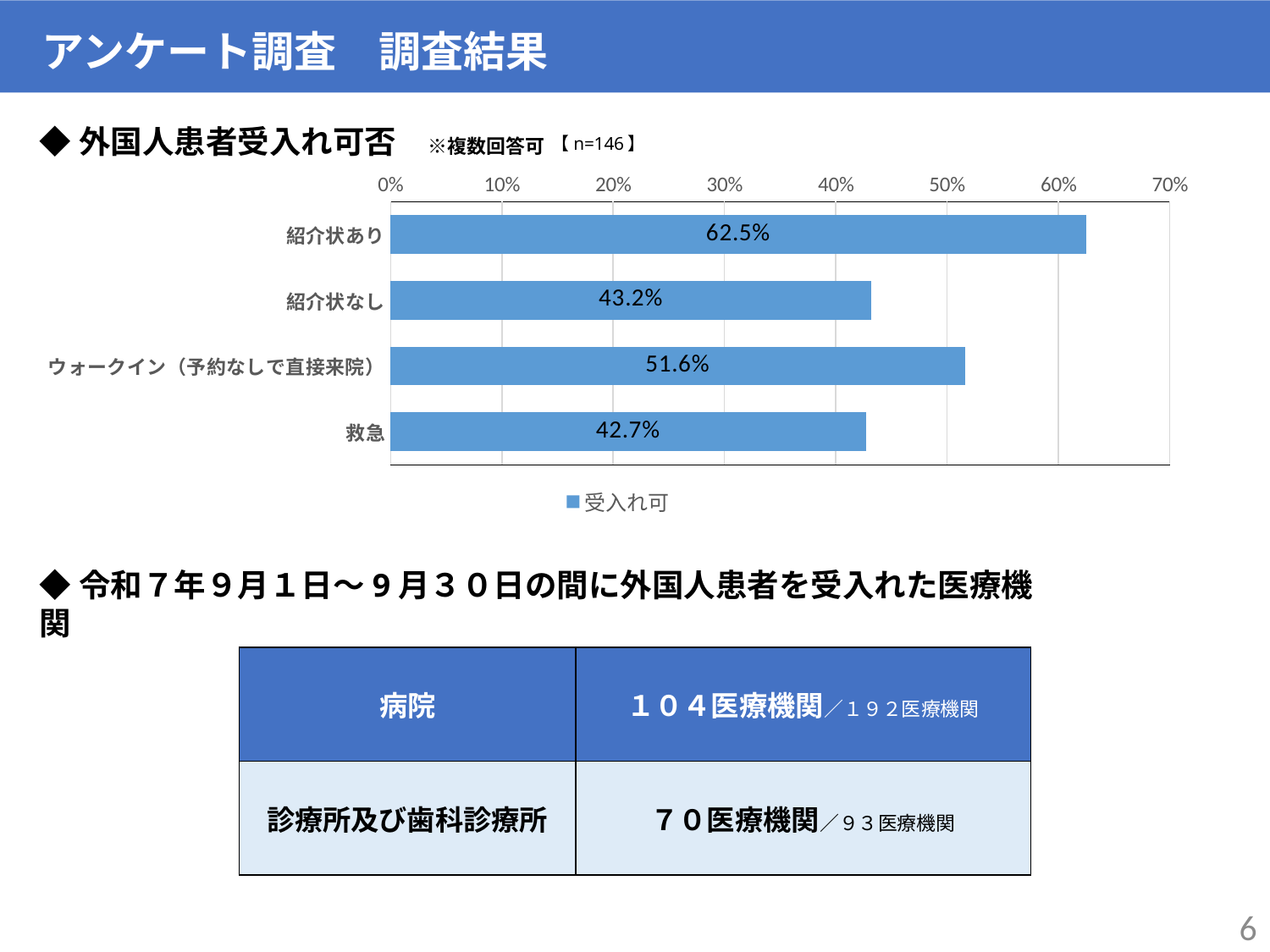
What is the difference between the values for 紹介状あり and 紹介状なし? 19.3% What is the legend entry shown below the chart? 受入れ可 What kind of chart is shown on the slide? bar chart How many categories are shown in the chart? 4 What is the value for ウォークイン（予約なしで直接来院） in the chart? 51.6% What is the value for 救急 in the chart? 42.7% What is the value for 紹介状あり in the 外国人患者受入れ可否 chart? 62.5% What is the value for 紹介状なし in the chart? 43.2% Which is larger, the value for ウォークイン（予約なしで直接来院） or the value for 救急? ウォークイン（予約なしで直接来院） Is the value for 紹介状あり greater or less than 60%? greater Which category has the lowest value in the chart? 救急 Which category has the highest value in the chart? 紹介状あり